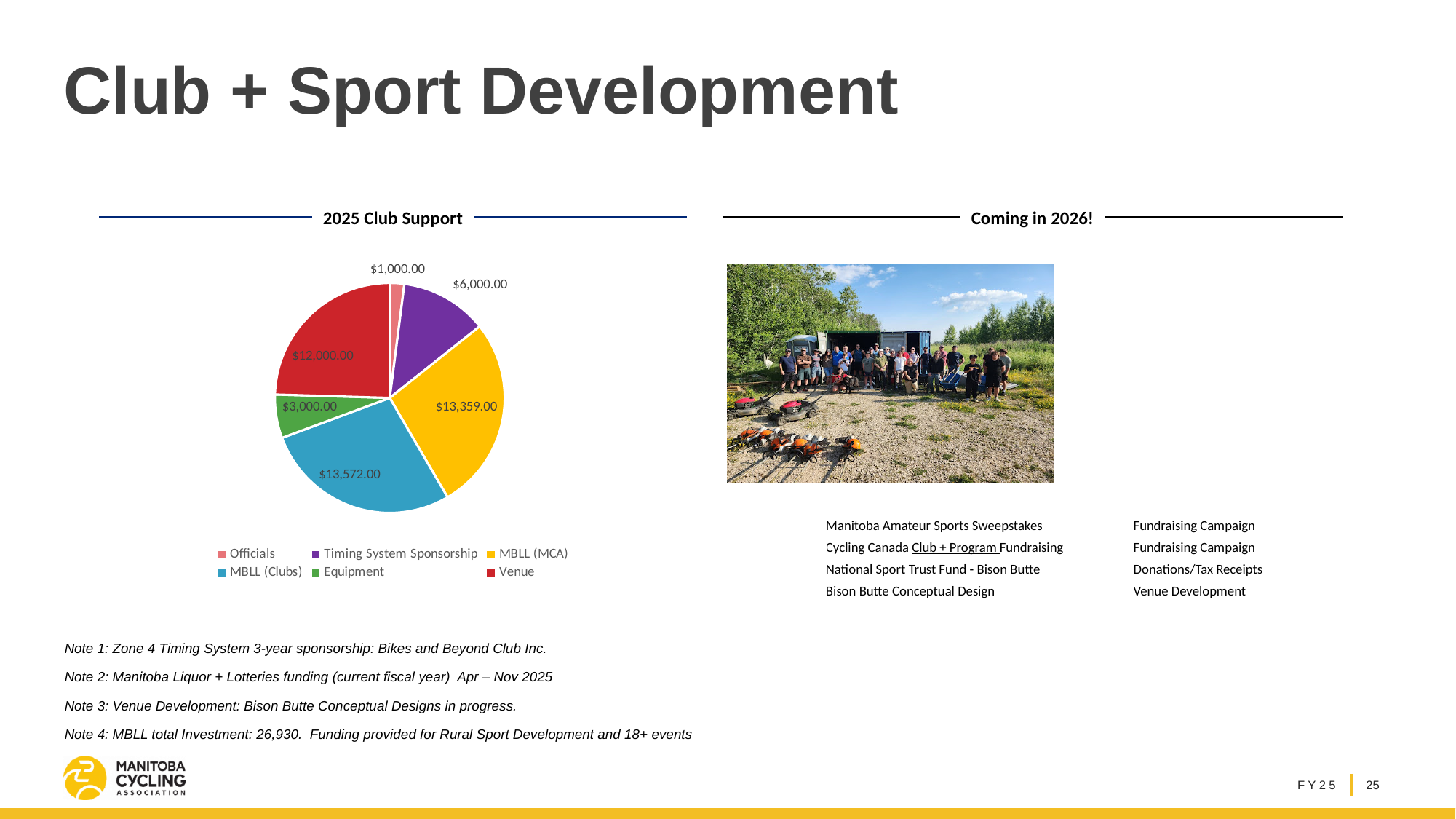
How many categories does the legend of the 2025 Club Support pie chart list? 6 What is the title of the pie chart on the slide? 2025 Club Support In the 2025 Club Support pie chart, what is the value for MBLL (MCA)? $13,359.00 In the 2025 Club Support pie chart, what is the value for Venue? $12,000.00 In the 2025 Club Support pie chart, which is larger: Venue or Timing System Sponsorship? Venue Which category has the largest value in the 2025 Club Support pie chart? MBLL (Clubs) In the 2025 Club Support pie chart, what is the value for Timing System Sponsorship? $6,000.00 What colour is the Venue slice in the 2025 Club Support pie chart? Red What type of chart is shown under the heading "2025 Club Support"? Pie chart Which category has the smallest slice in the 2025 Club Support pie chart? Officials In the 2025 Club Support pie chart, what is the difference between the Venue value and the Equipment value? $9,000.00 In the 2025 Club Support pie chart, what is the value for Equipment? $3,000.00